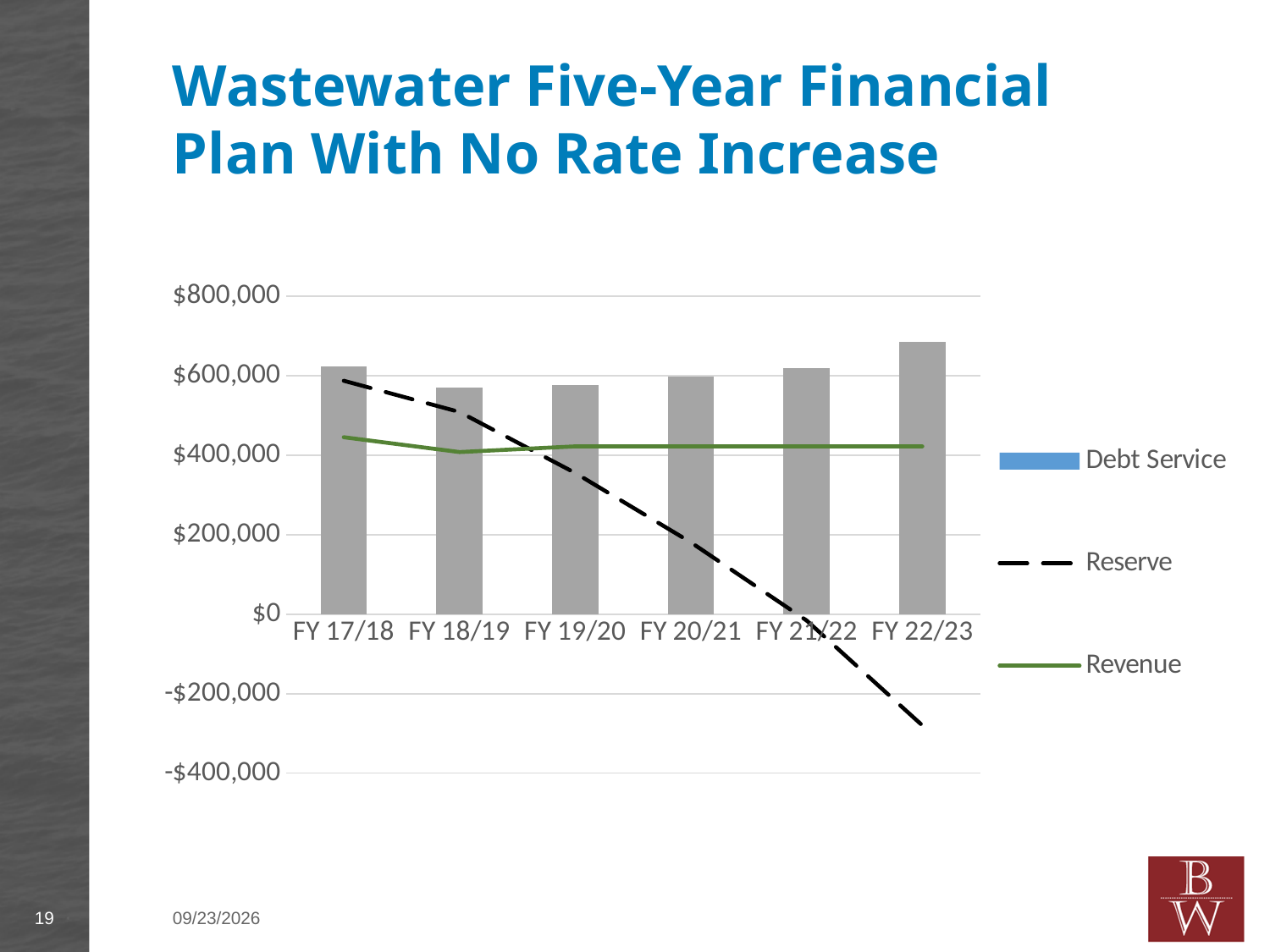
How many fiscal years are shown on the x axis of the chart? 6 What kind of chart is shown on the slide? A combined bar and line chart Which series in the chart is plotted as bars? Debt Service Is the Debt Service value for FY 22/23 greater or less than $600,000? greater How many series does the chart legend list? 3 Which series in the chart is drawn as a dashed line? Reserve Does the Reserve line rise or fall from FY 17/18 to FY 22/23? Fall In which fiscal year is the Debt Service bar the highest? FY 22/23 Which is larger, the Debt Service bar for FY 22/23 or the Debt Service bar for FY 17/18? FY 22/23 Is the Reserve value for FY 22/23 greater or less than $0? less Is the Debt Service value for FY 18/19 greater or less than $600,000? less Which is larger in FY 17/18, the Reserve value or the Revenue value? Reserve